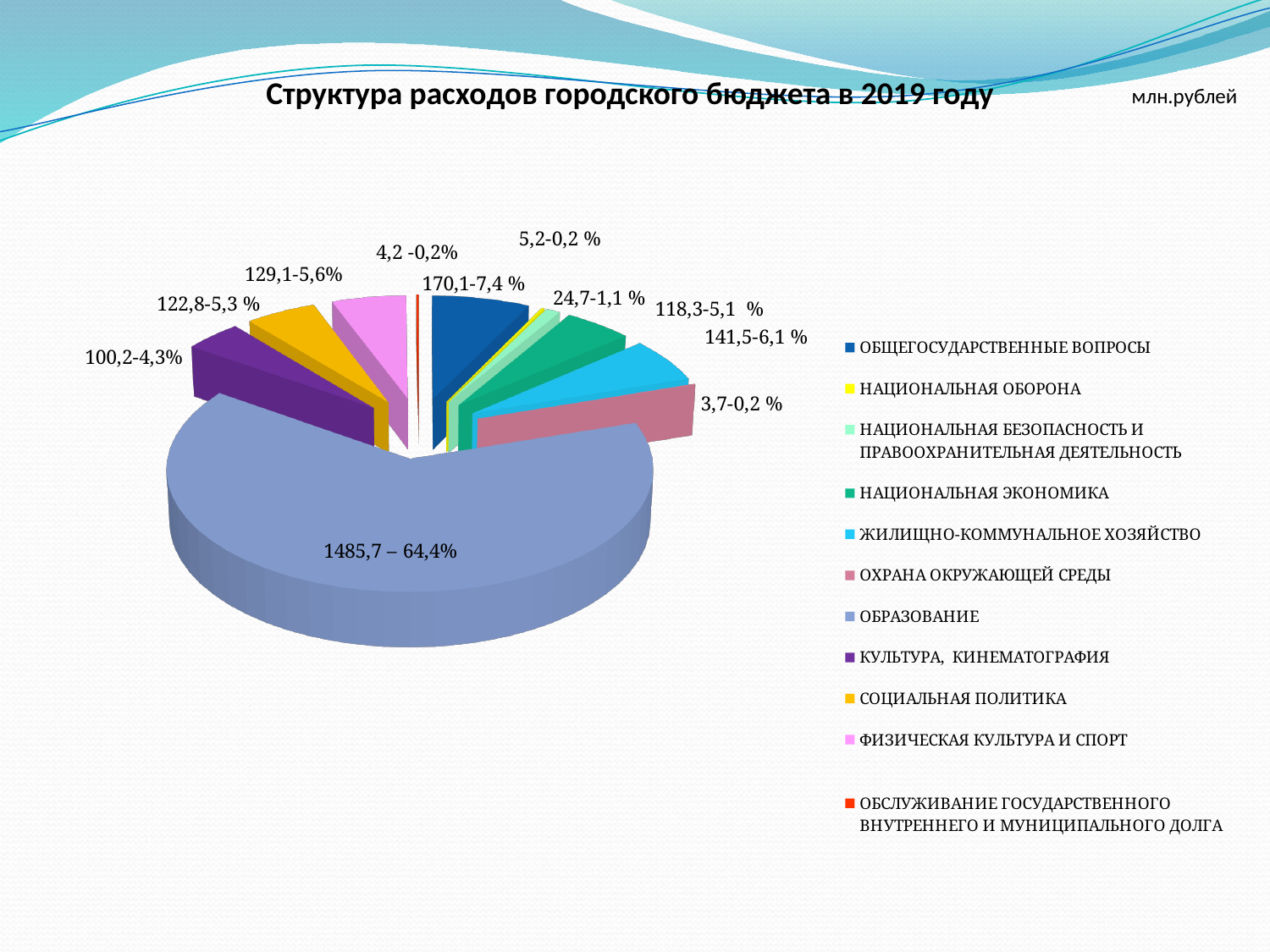
What share of the pie does ЖИЛИЩНО-КОММУНАЛЬНОЕ ХОЗЯЙСТВО account for? 6,1 % What share of the pie does ОБРАЗОВАНИЕ account for? 64,4% What is the value shown for НАЦИОНАЛЬНАЯ ЭКОНОМИКА? 118,3 What is the value shown for ОБРАЗОВАНИЕ? 1485,7 How many categories does the legend of the pie chart list? 11 In what units are the values on the chart given? млн.рублей Which category has the largest slice of the pie chart? ОБРАЗОВАНИЕ Which is larger, the value for СОЦИАЛЬНАЯ ПОЛИТИКА or the value for КУЛЬТУРА, КИНЕМАТОГРАФИЯ? СОЦИАЛЬНАЯ ПОЛИТИКА What is the value shown for ОБЩЕГОСУДАРСТВЕННЫЕ ВОПРОСЫ? 170,1 What is the difference between the value for ОБЩЕГОСУДАРСТВЕННЫЕ ВОПРОСЫ and the value for ЖИЛИЩНО-КОММУНАЛЬНОЕ ХОЗЯЙСТВО? 28,6 What is the title of the chart on the slide? Структура расходов городского бюджета в 2019 году What kind of chart is shown on the slide? pie chart